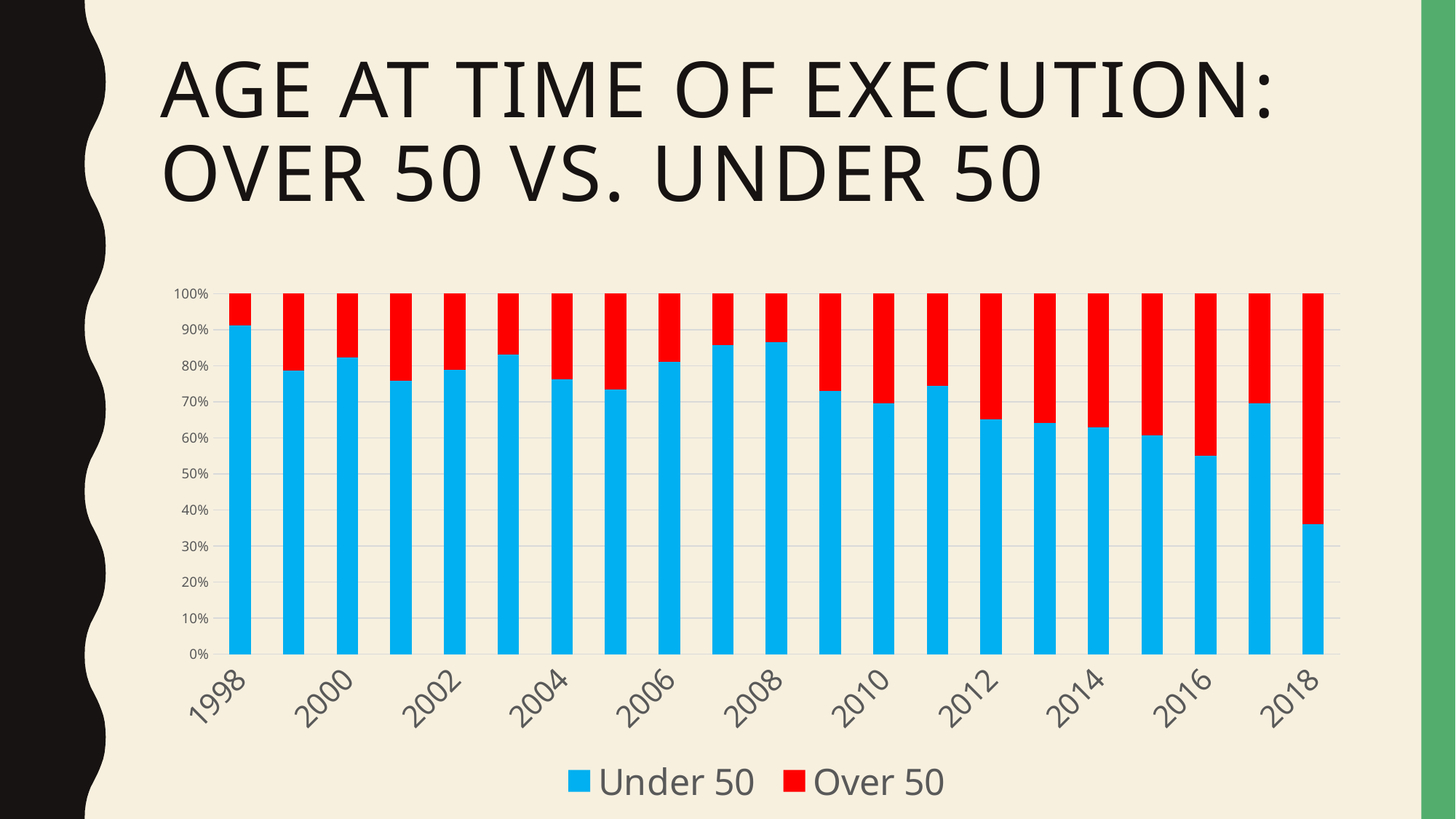
How many series does the legend list? 2 Which year has the lowest share of executions for Under 50? 2018 Does the Under 50 share generally rise or fall from 1998 to 2018? Fall Is the Under 50 share in 2008 greater or less than 80%? greater Which year has the highest share of executions for Under 50? 1998 How many bars (years) are plotted in the chart? 21 Which year has the largest share for Over 50? 2018 Is the Under 50 share in 2016 greater or less than 50%? greater Is the Under 50 share in 2018 greater or less than 40%? less Which colour represents the Over 50 series in the legend? Red What kind of chart is shown on the slide? Bar chart In 2018, which is larger: the Under 50 share or the Over 50 share? Over 50